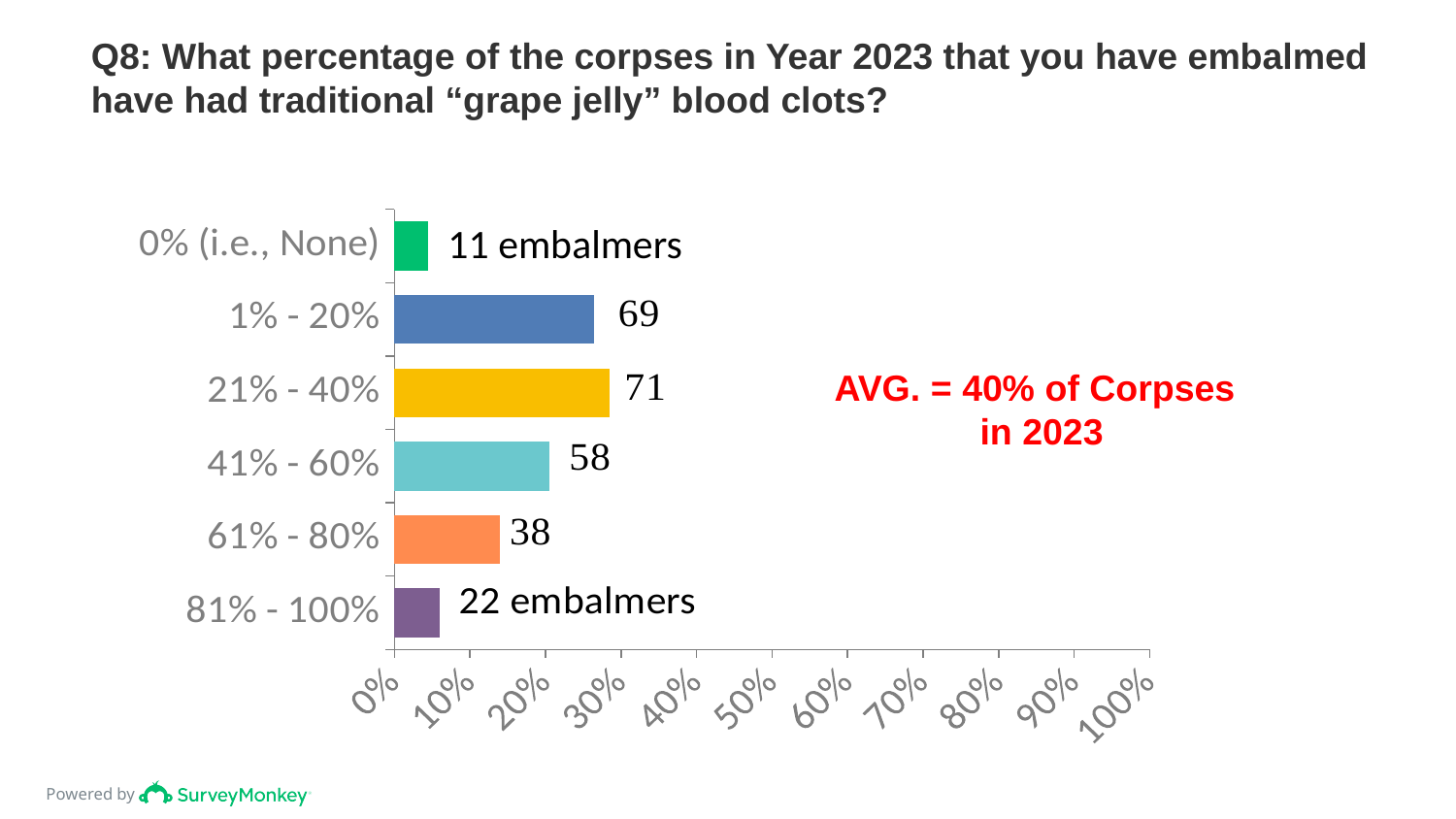
What is the difference between the values for 21% - 40% and 1% - 20%? 2 Which category has the highest value? 21% - 40% What is the data label for the 81% - 100% category? 22 embalmers What is the data label for the 1% - 20% category? 69 Is the bar for 61% - 80% greater or less than 20% on the axis? less What is the data label for the 61% - 80% category? 38 Which category has the lowest value? 0% (i.e., None) How many categories are shown on the chart? 6 What is the data label for the 0% (i.e., None) category? 11 embalmers What is the difference between the values for 41% - 60% and 61% - 80%? 20 What kind of chart is shown on the slide? Bar chart Which is larger, the value for 41% - 60% or the value for 61% - 80%? 41% - 60%